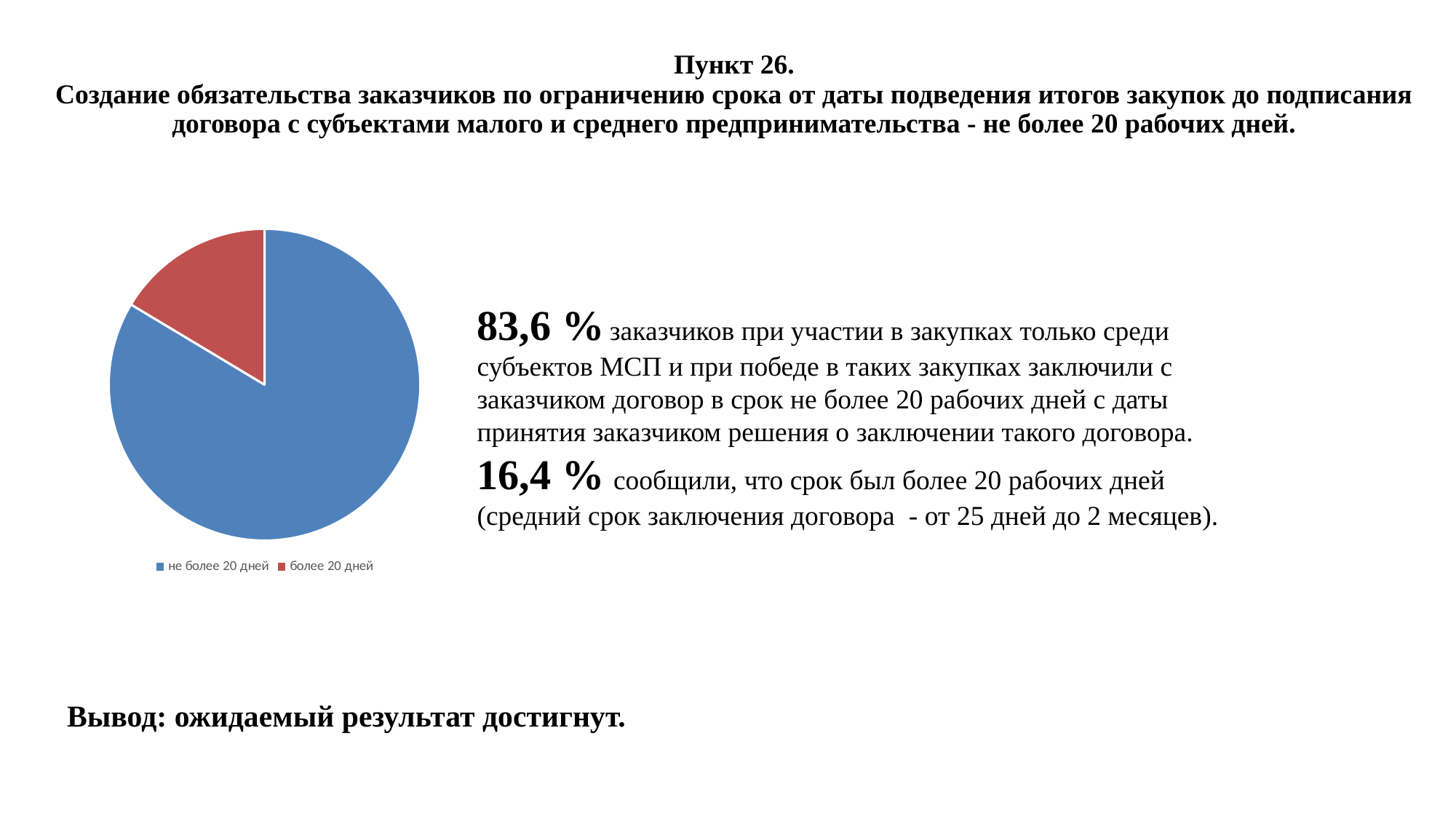
What share of the pie does the "более 20 дней" slice represent, according to the slide? 16,4 % What share of the pie does the "не более 20 дней" slice represent, according to the slide? 83,6 % What kind of chart is shown on the slide? pie chart What colour is the "не более 20 дней" slice in the pie chart? blue What colour is the "более 20 дней" slice in the pie chart? red Which slice of the pie chart is the largest? не более 20 дней Which slice of the pie chart is the smallest? более 20 дней How many entries does the legend of the pie chart list? 2 What is the difference between the shares of the "не более 20 дней" and "более 20 дней" slices? 67,2 % Which is larger in the pie chart: the slice for "не более 20 дней" or the slice for "более 20 дней"? не более 20 дней How many slices does the pie chart have? 2